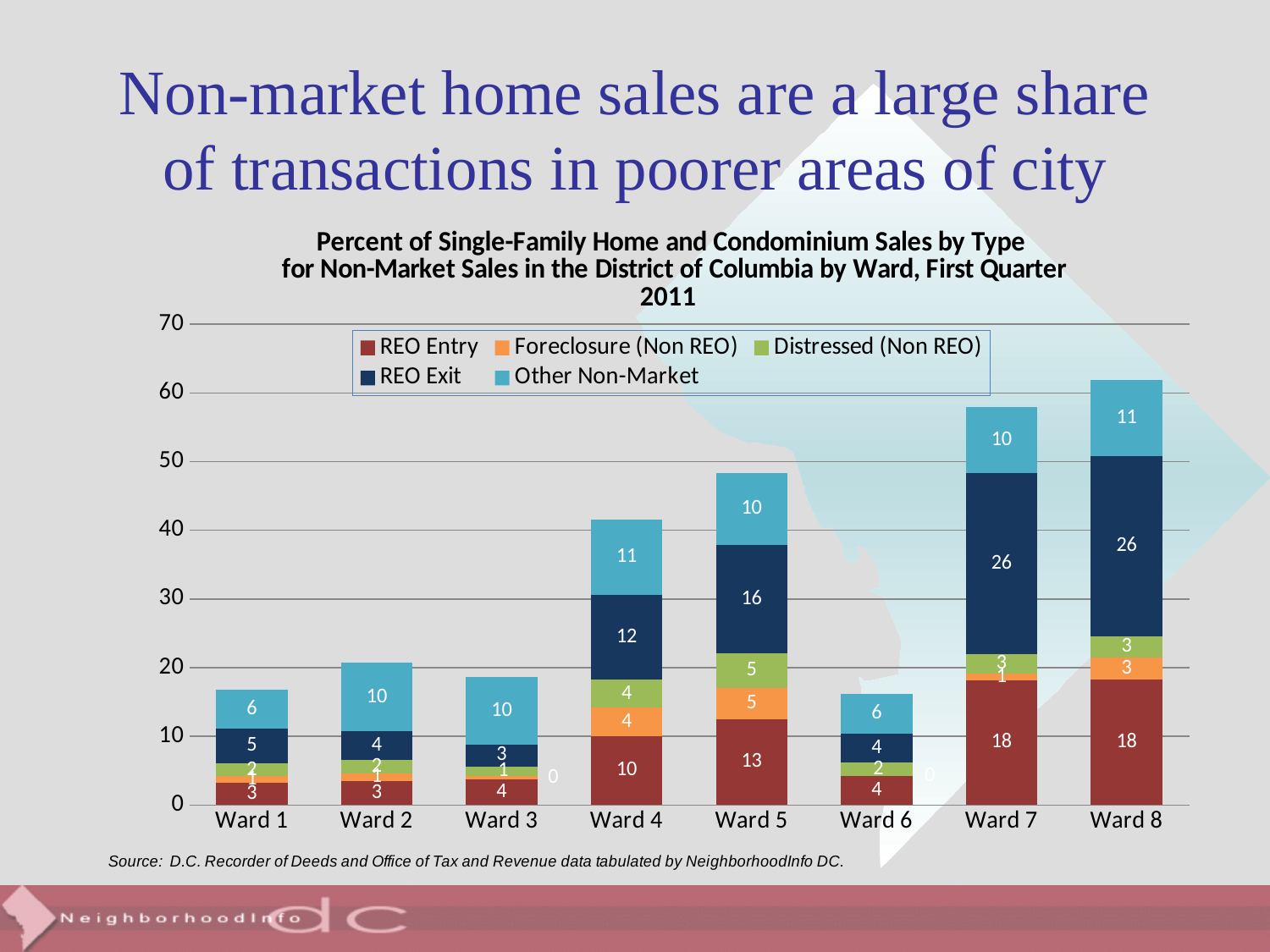
What is the total of the stacked bar for Ward 4? 41 What is the difference between the REO Exit values for Ward 8 and Ward 5? 10 Is the total stacked bar for Ward 7 greater or less than 50? greater How many series does the legend list? 5 Which ward has the tallest stacked bar overall? Ward 8 How many wards are shown on the x axis? 8 What is the total of the stacked bar for Ward 5? 49 What is the REO Entry value for Ward 8? 18 What is the REO Exit value for Ward 5? 16 What is the Other Non-Market value for Ward 4? 11 What kind of chart is shown on the slide? Stacked bar chart Which ward has the larger REO Entry value, Ward 4 or Ward 5? Ward 5